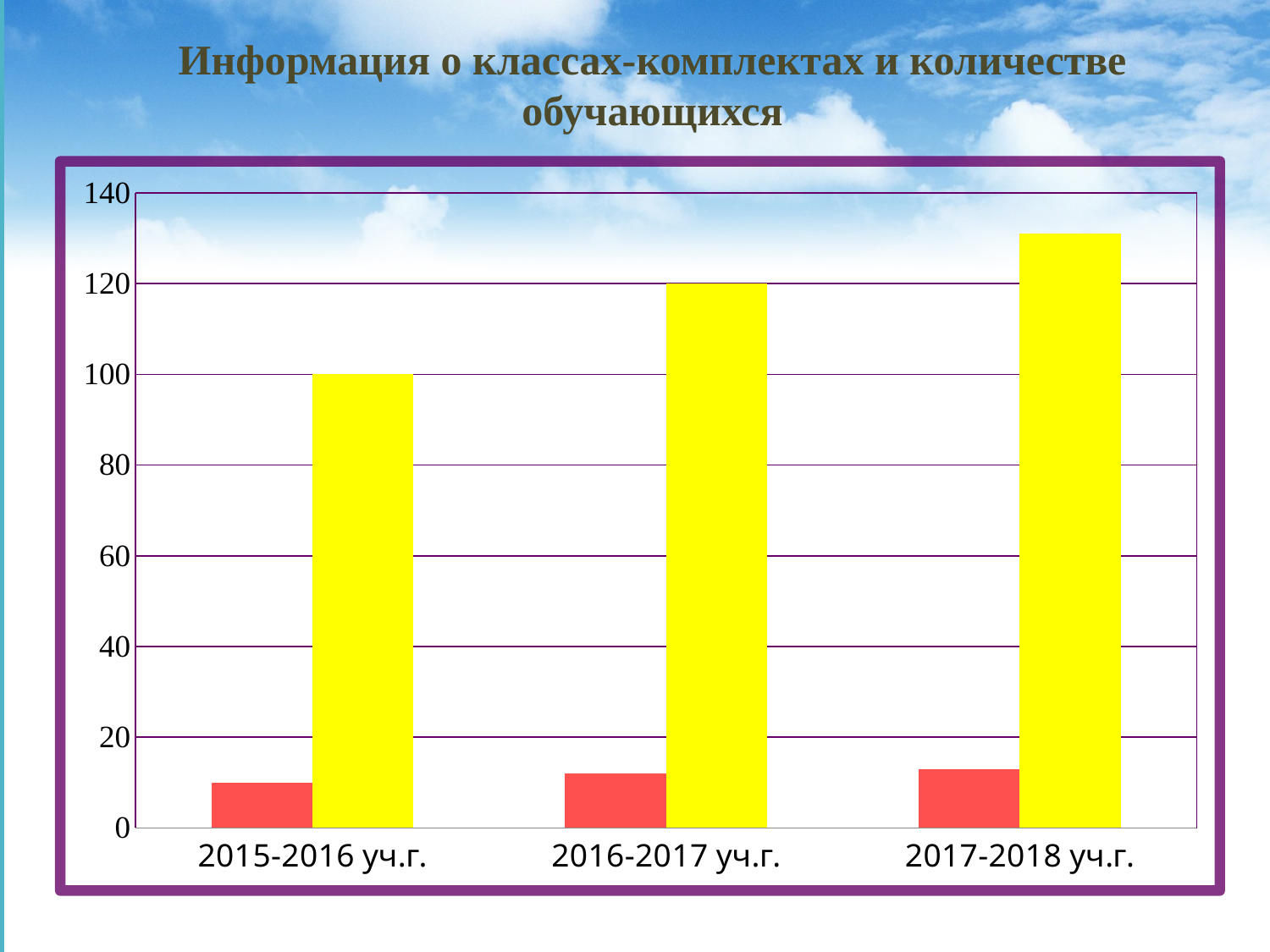
What is the value of the yellow bar for 2015-2016 уч.г.? 100 How many categories (school years) are shown on the x axis? 3 Is the value of the red bar for 2015-2016 уч.г. greater or less than 20? less What is the title of the slide above the chart? Информация о классах-комплектах и количестве обучающихся What kind of chart is shown on the slide? bar chart Is the value of the yellow bar for 2017-2018 уч.г. greater or less than 120? greater By how much does the yellow bar for 2016-2017 уч.г. exceed the yellow bar for 2015-2016 уч.г.? 20 Is the value of the red bar for 2017-2018 уч.г. greater or less than 20? less Which school year has the lowest yellow bar? 2015-2016 уч.г. Which school year has the highest yellow bar? 2017-2018 уч.г. What is the value of the yellow bar for 2016-2017 уч.г.? 120 Do the yellow bars rise or fall from 2015-2016 уч.г. to 2017-2018 уч.г.? rise